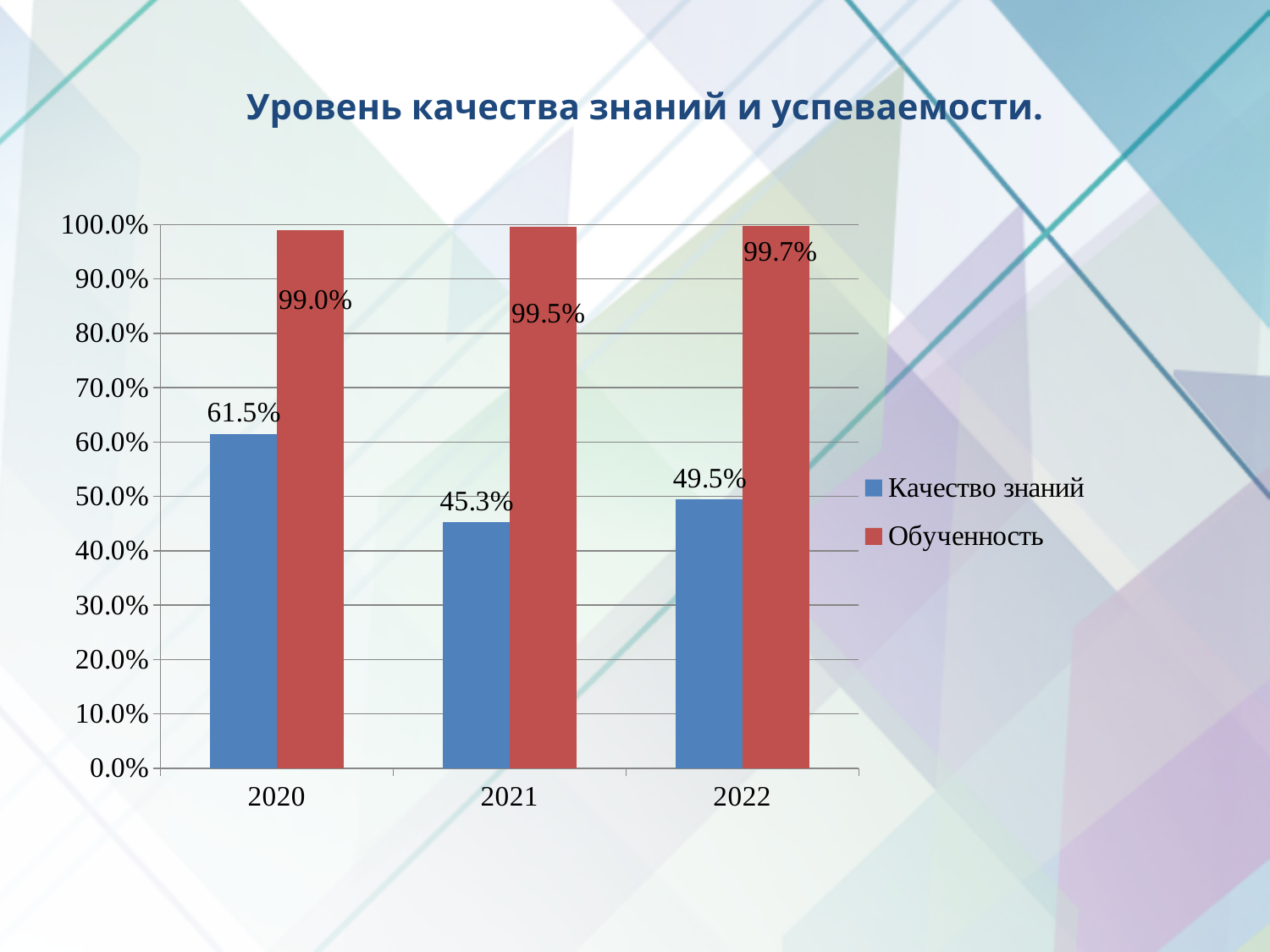
What is the value of Качество знаний for 2022? 49.5% How many years are shown on the x axis? 3 What is the value of Обученность for 2021? 99.5% What kind of chart is shown on the slide? Bar chart In which year is Качество знаний the lowest? 2021 What is the difference between Качество знаний in 2020 and in 2021? 16.2% Which is larger: Качество знаний in 2022 or Качество знаний in 2021? Качество знаний in 2022 What is the value of Качество знаний for 2020? 61.5% How many series does the legend list? 2 In which year is Качество знаний the highest? 2020 What is the value of Обученность for 2022? 99.7% What is the title of the chart? Уровень качества знаний и успеваемости.